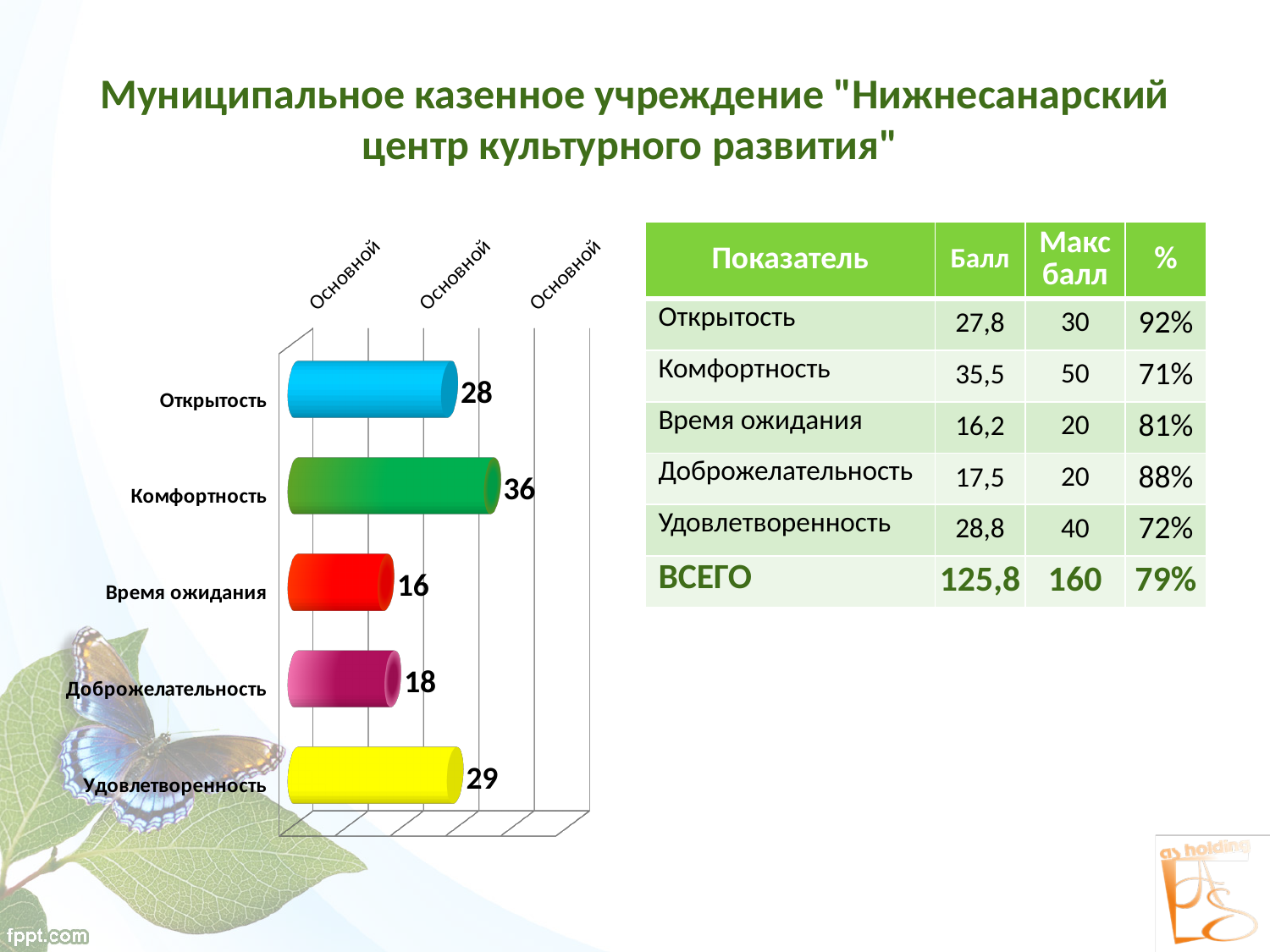
What is the value shown for Открытость in the chart? 28 How many categories are plotted in the chart? 5 What is the difference between the values for Комфортность and Время ожидания in the chart? 20 What is the value shown for Время ожидания in the chart? 16 What colour is the bar for Удовлетворенность in the chart? Yellow Which is larger in the chart, the value for Открытость or the value for Удовлетворенность? Удовлетворенность What is the value shown for Доброжелательность in the chart? 18 Which category has the highest value in the chart? Комфортность What type of chart is shown on the slide? Bar chart What is the value shown for Комфортность in the chart? 36 Which category has the lowest value in the chart? Время ожидания What is the value shown for Удовлетворенность in the chart? 29